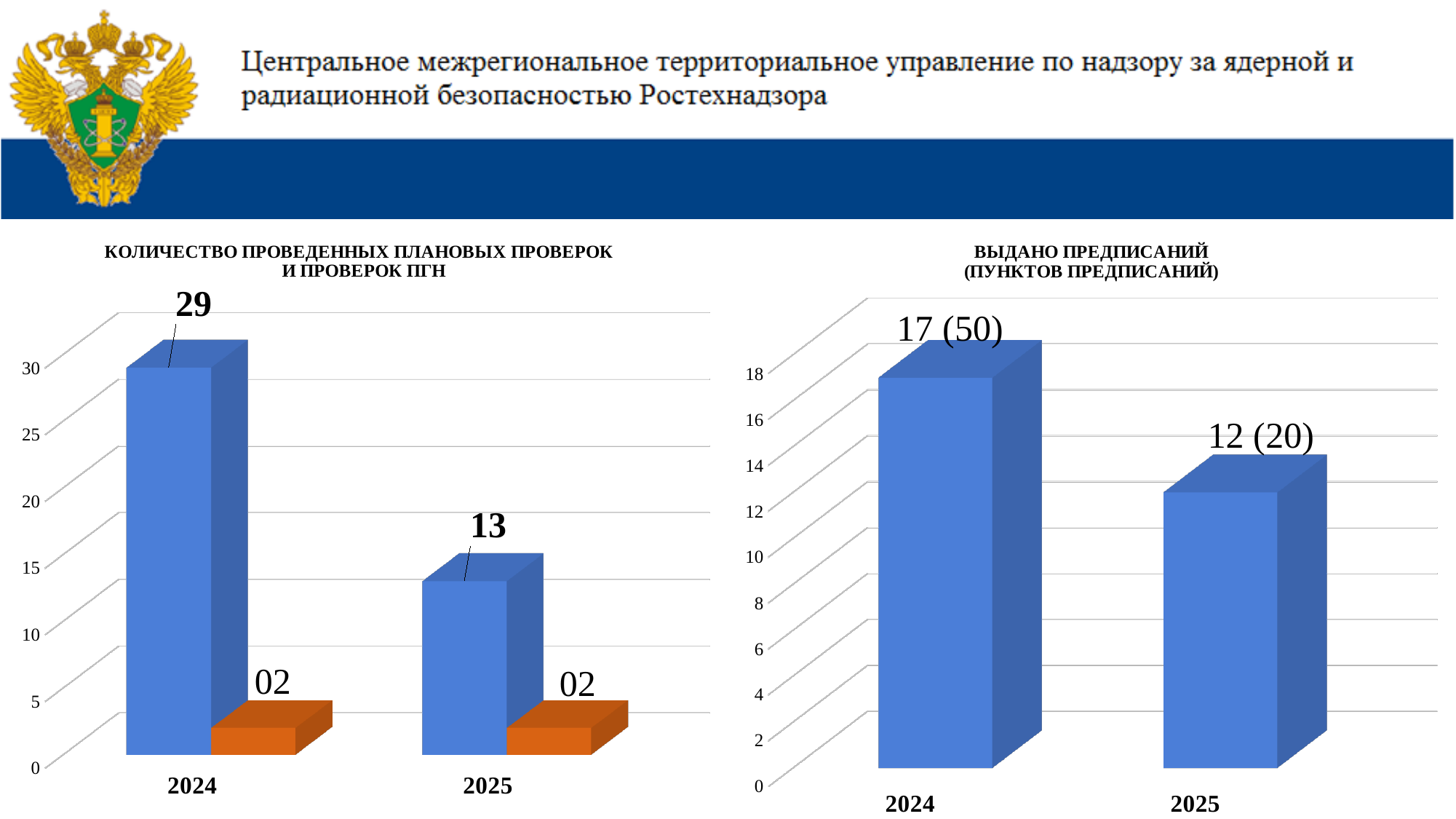
In the left chart (КОЛИЧЕСТВО ПРОВЕДЕННЫХ ПЛАНОВЫХ ПРОВЕРОК И ПРОВЕРОК ПГН), what is the value of the blue bar for 2024? 29 In the right chart (ВЫДАНО ПРЕДПИСАНИЙ), which year has the lower bar? 2025 In the left chart (КОЛИЧЕСТВО ПРОВЕДЕННЫХ ПЛАНОВЫХ ПРОВЕРОК И ПРОВЕРОК ПГН), which year has the taller blue bar? 2024 In the left chart (КОЛИЧЕСТВО ПРОВЕДЕННЫХ ПЛАНОВЫХ ПРОВЕРОК И ПРОВЕРОК ПГН), how many years are shown on the x axis? 2 In the left chart (КОЛИЧЕСТВО ПРОВЕДЕННЫХ ПЛАНОВЫХ ПРОВЕРОК И ПРОВЕРОК ПГН), what is the value of the blue bar for 2025? 13 In the right chart (ВЫДАНО ПРЕДПИСАНИЙ), what is the data label on the bar for 2024? 17 (50) In the left chart (КОЛИЧЕСТВО ПРОВЕДЕННЫХ ПЛАНОВЫХ ПРОВЕРОК И ПРОВЕРОК ПГН), what value is labelled on the orange bar for 2024? 02 What type of chart is the right chart (ВЫДАНО ПРЕДПИСАНИЙ)? bar chart In the left chart (КОЛИЧЕСТВО ПРОВЕДЕННЫХ ПЛАНОВЫХ ПРОВЕРОК И ПРОВЕРОК ПГН), do the blue bar values rise or fall from 2024 to 2025? fall In the right chart (ВЫДАНО ПРЕДПИСАНИЙ), what is the data label on the bar for 2025? 12 (20) In the left chart (КОЛИЧЕСТВО ПРОВЕДЕННЫХ ПЛАНОВЫХ ПРОВЕРОК И ПРОВЕРОК ПГН), by how much does the blue bar for 2024 exceed the blue bar for 2025? 16 In the right chart (ВЫДАНО ПРЕДПИСАНИЙ), is the bar for 2025 greater or less than 14? less